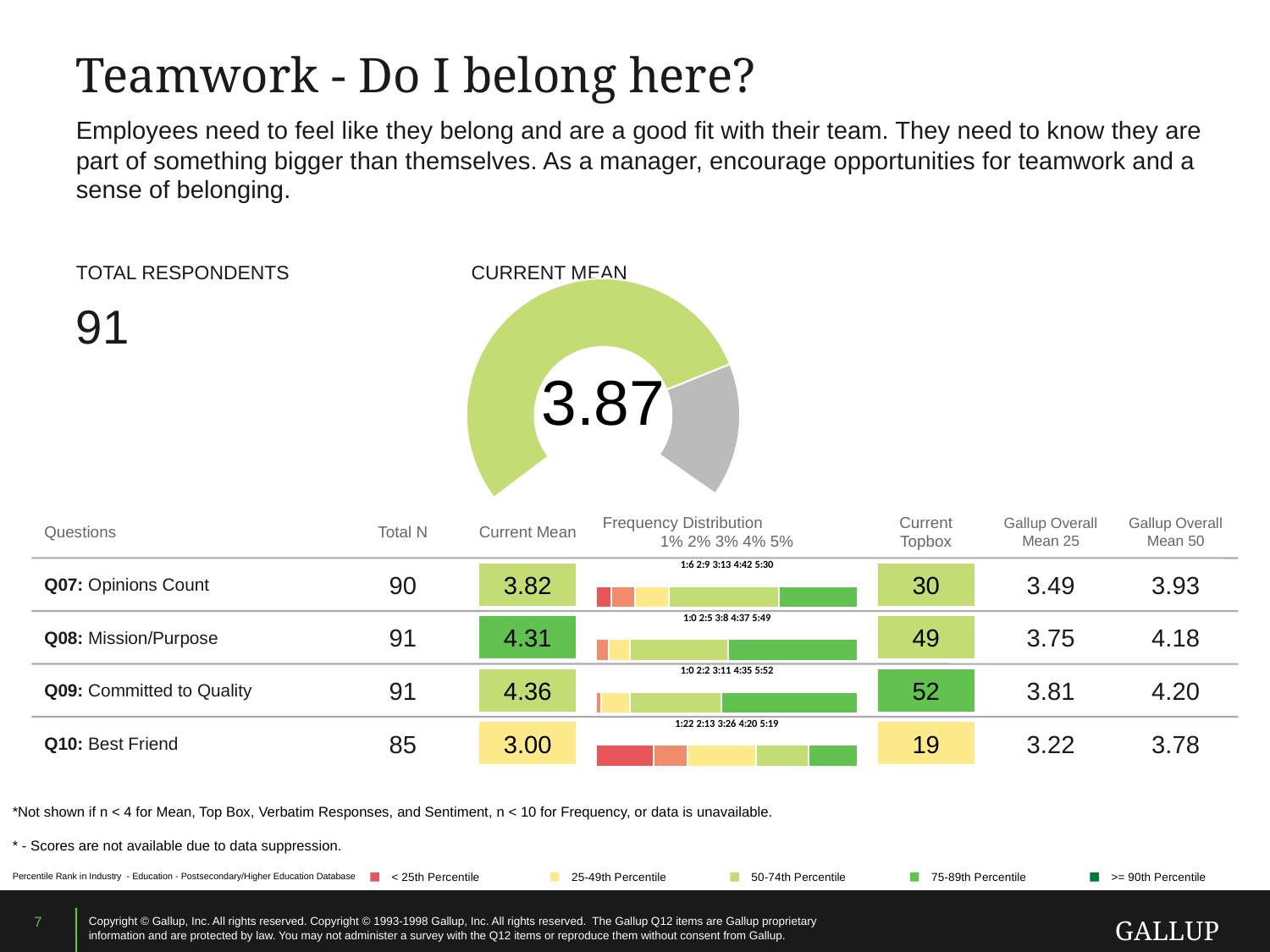
In the Frequency Distribution bar for Q10: Best Friend, what is the value for response 1? 22 How many percentile categories does the legend at the bottom of the slide list? 5 Which question has the highest Current Mean in the table? Q09: Committed to Quality Which has the larger Current Topbox, Q08: Mission/Purpose or Q09: Committed to Quality? Q09: Committed to Quality What kind of chart is used to display the CURRENT MEAN? gauge chart What is the total of the Frequency Distribution values for Q07: Opinions Count? 100 What is the difference between the Current Mean of Q09: Committed to Quality and Q07: Opinions Count? 0.54 In the Frequency Distribution bar for Q07: Opinions Count, what is the value for response 5? 30 In the Frequency Distribution bar for Q08: Mission/Purpose, what is the value for response 4? 37 What value does the CURRENT MEAN gauge chart show? 3.87 Which question has the lowest Current Mean in the table? Q10: Best Friend In the Frequency Distribution bar for Q09: Committed to Quality, what is the value for response 5? 52